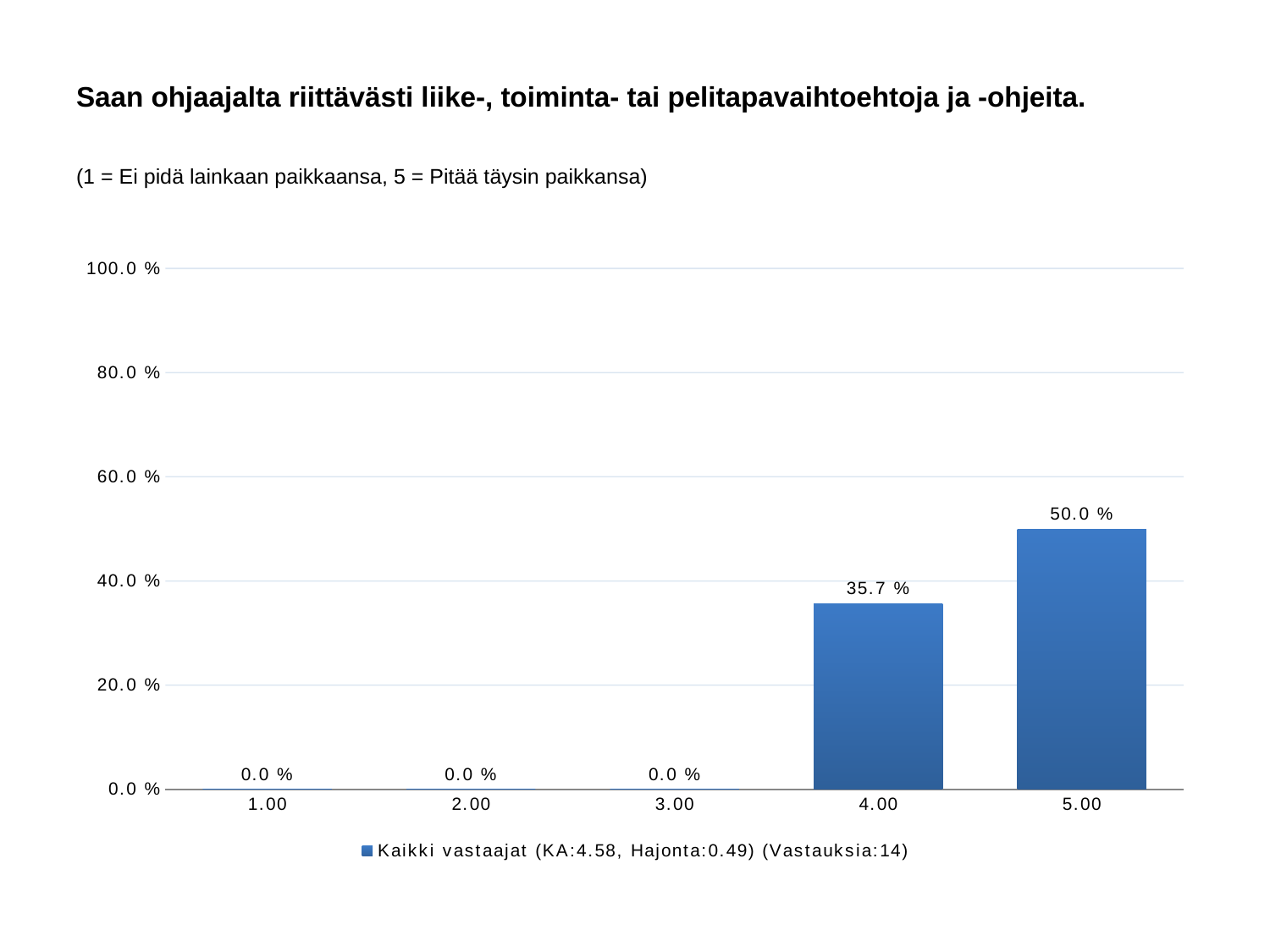
What is the difference between the values for 5.00 and 4.00? 14.3 % Which category has the highest value? 5.00 Which is larger, the value for 4.00 or the value for 5.00? 5.00 What is the value for category 1.00? 0.0 % How many series does the legend list? 1 How many categories have a value of 0.0 %? 3 What number of responses (Vastauksia) does the legend state? 14 How many categories are shown on the x axis? 5 What is the value for category 4.00? 35.7 % What kind of chart is shown? bar chart What is the value for category 5.00? 50.0 % Is the value for 4.00 greater or less than 40.0 %? less